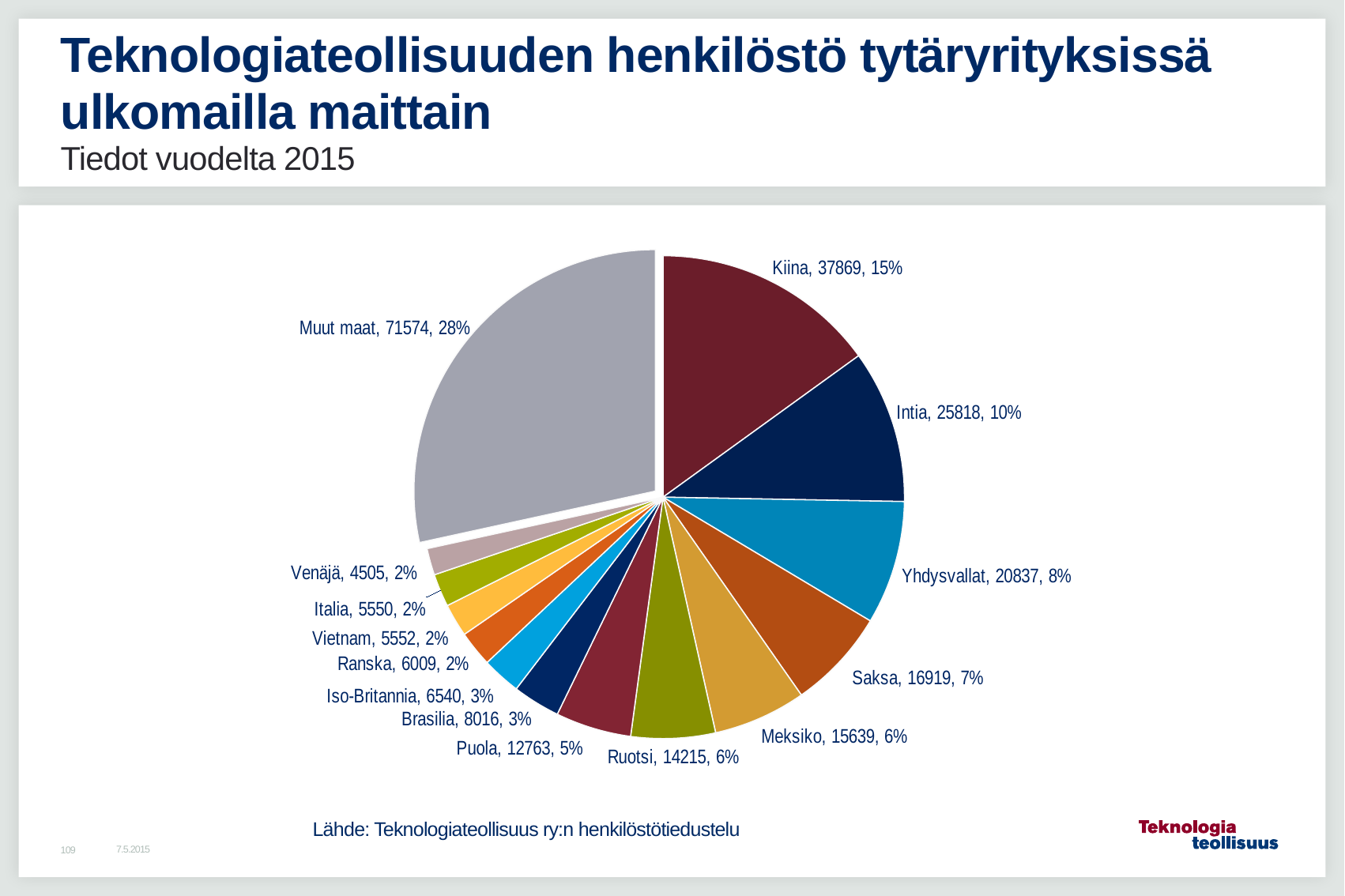
Which slice is pulled out (exploded) from the rest of the pie? Muut maat What is the difference between the values for Kiina and Intia? 12051 What is the value shown for Puola? 12763 What is the value shown for Yhdysvallat? 20837 How many employees does the chart show for Kiina? 37869 What kind of chart is shown on the slide? pie chart What share of the pie does Intia represent? 10% How many slices does the pie chart have? 14 Which slice of the pie is the largest? Muut maat What share of the pie does Muut maat represent? 28% Which has a larger value, Saksa or Meksiko? Saksa Which slice of the pie is the smallest? Venäjä